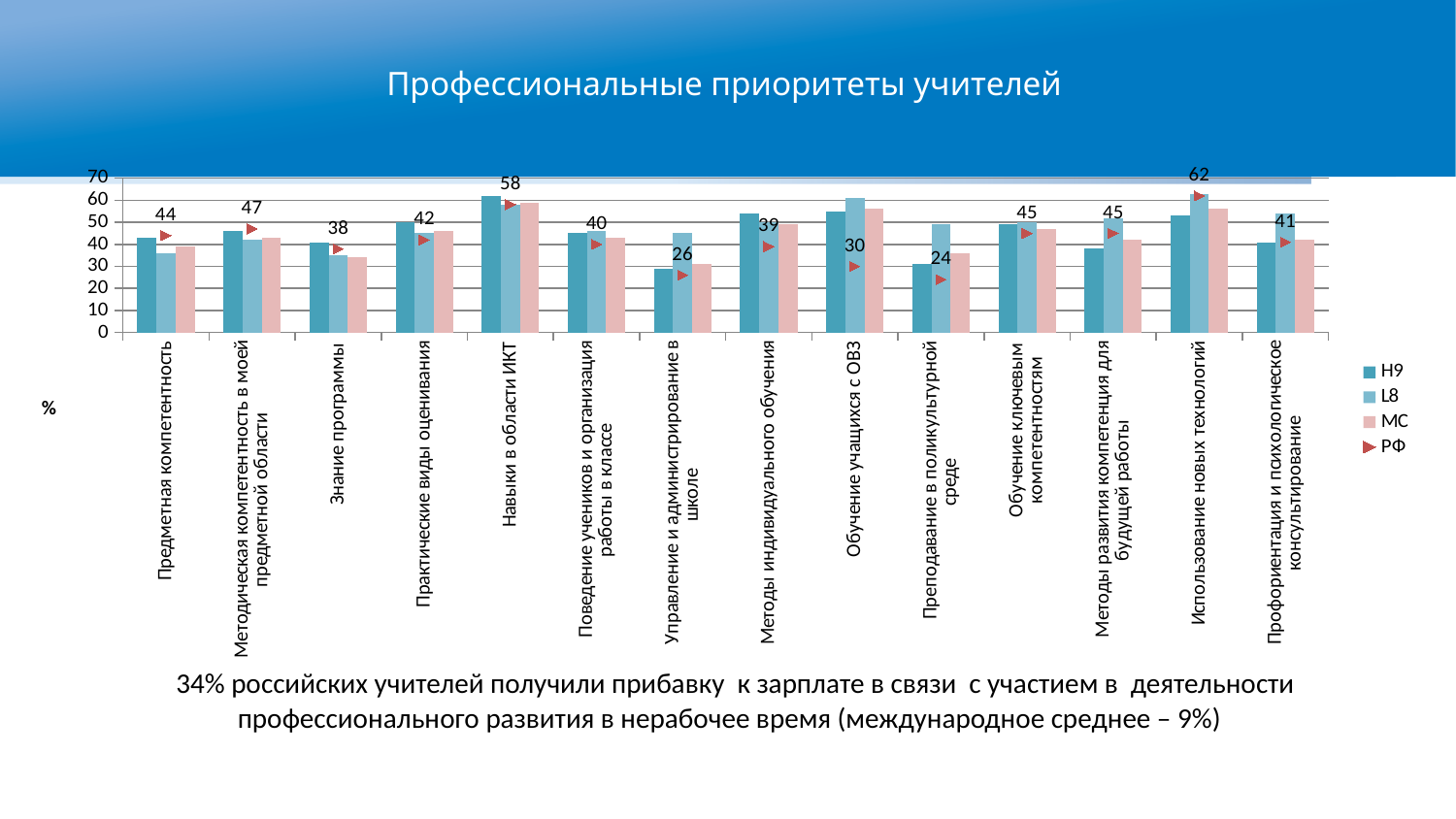
How many series does the chart legend list? 4 Is the Н9 value for 'Преподавание в поликультурной среде' greater or less than 40? less Which category has the highest labelled РФ value? Использование новых технологий What is the labelled РФ value for 'Обучение учащихся с ОВЗ'? 30 What is the labelled РФ value for 'Навыки в области ИКТ'? 58 What is the title of the chart? Профессиональные приоритеты учителей What is the labelled РФ value for 'Знание программы'? 38 Which has the larger labelled РФ value: 'Предметная компетентность' or 'Методическая компетентность в моей предметной области'? Методическая компетентность в моей предметной области How many categories are shown along the x axis of the chart? 14 What kind of chart is shown on the slide? bar chart What is the difference between the labelled РФ values for 'Использование новых технологий' and 'Преподавание в поликультурной среде'? 38 Which category has the lowest labelled РФ value? Преподавание в поликультурной среде